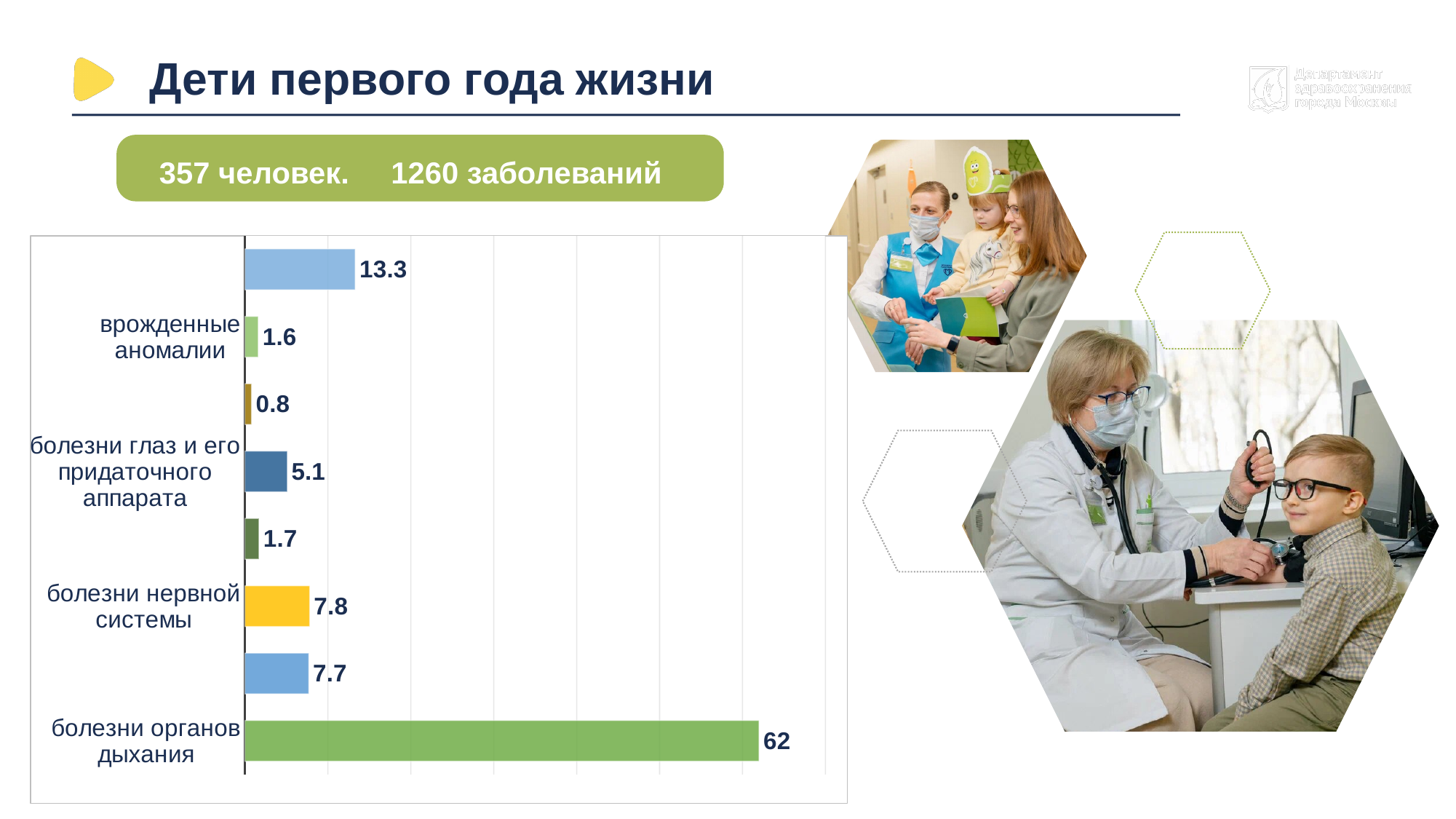
What is the difference between the values for болезни органов дыхания and болезни нервной системы? 54.2 What is the value for врожденные аномалии? 1.6 What is the value for болезни органов дыхания? 62 What is the difference between the values for болезни глаз и его придаточного аппарата and врожденные аномалии? 3.5 What is the smallest value printed on the chart? 0.8 How many bars are plotted on the chart? 8 What kind of chart is shown on the slide? bar chart What is the value for болезни нервной системы? 7.8 Which labelled category has the highest value? болезни органов дыхания What is the value for болезни глаз и его придаточного аппарата? 5.1 Which is larger, the value for болезни нервной системы or the value for болезни глаз и его придаточного аппарата? болезни нервной системы What is the title of the slide? Дети первого года жизни